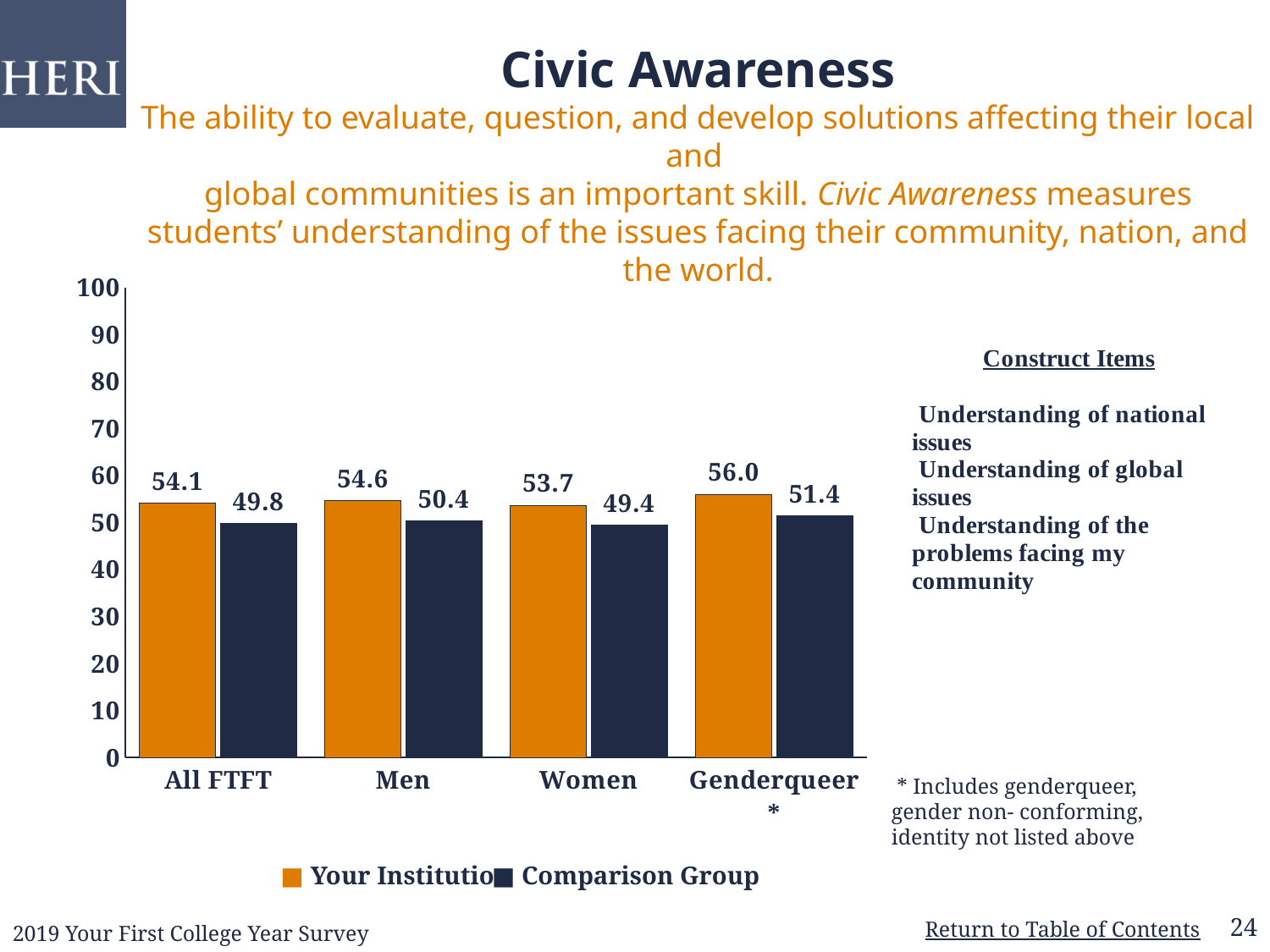
Which category has the lowest Comparison Group value? Women How many series does the legend list? 2 What is the Comparison Group value for Women? 49.4 Which is larger for Men: the Your Institution value or the Comparison Group value? Your Institution What kind of chart is shown on the slide? bar chart Is the Comparison Group value for Genderqueer greater or less than 60? less What is the Your Institution value for Men? 54.6 Which category has the highest Your Institution value? Genderqueer How many categories are shown on the x axis? 4 What is the Comparison Group value for All FTFT? 49.8 What is the Your Institution value for Genderqueer? 56.0 What is the difference between the Your Institution and Comparison Group values for All FTFT? 4.3